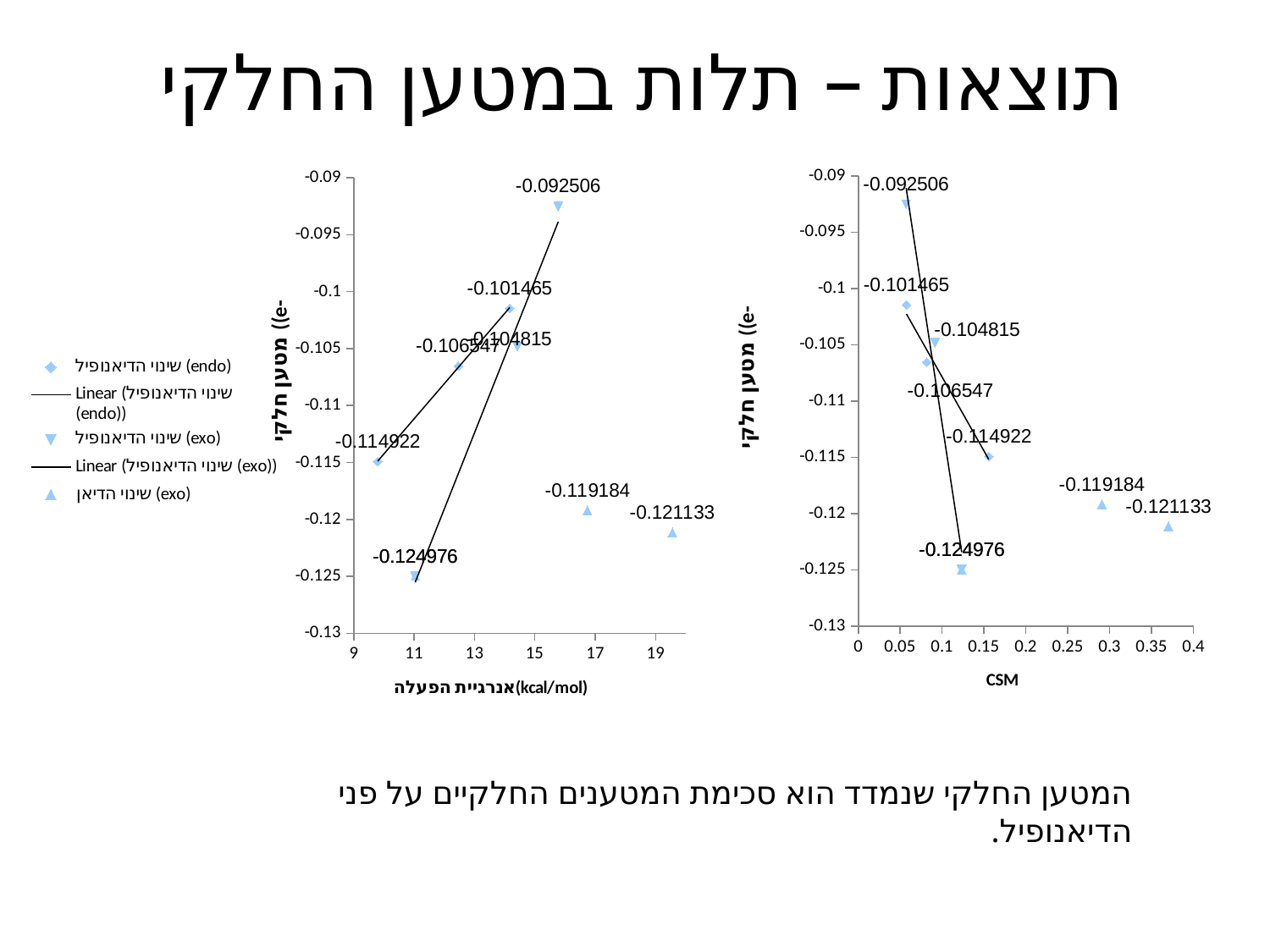
How many entries does the legend list? 5 On the right chart, which labeled data point has the lowest partial charge value? -0.124976 On the right chart, is the CSM value of the point labeled -0.121133 greater or less than 0.35? greater On the right chart, what is the x-axis label? CSM On the right chart, which labeled data point has the highest partial charge value? -0.092506 On the left chart, what is the difference between the highest labeled value (-0.092506) and the lowest labeled value (-0.124976)? 0.03247 On the right chart, which is larger: the value -0.101465 or the value -0.106547? -0.101465 On the left chart, is the activation energy of the point labeled -0.121133 greater or less than 19 kcal/mol? greater What kind of chart is the left chart on the slide? scatter chart On the left chart, what is the x-axis label? אנרגיית הפעלה (kcal/mol) On the left chart, what is the difference between the two labeled points of the שינוי הדיאן (exo) series, -0.119184 and -0.121133? 0.001949 On the left chart, how many data points have printed value labels? 8